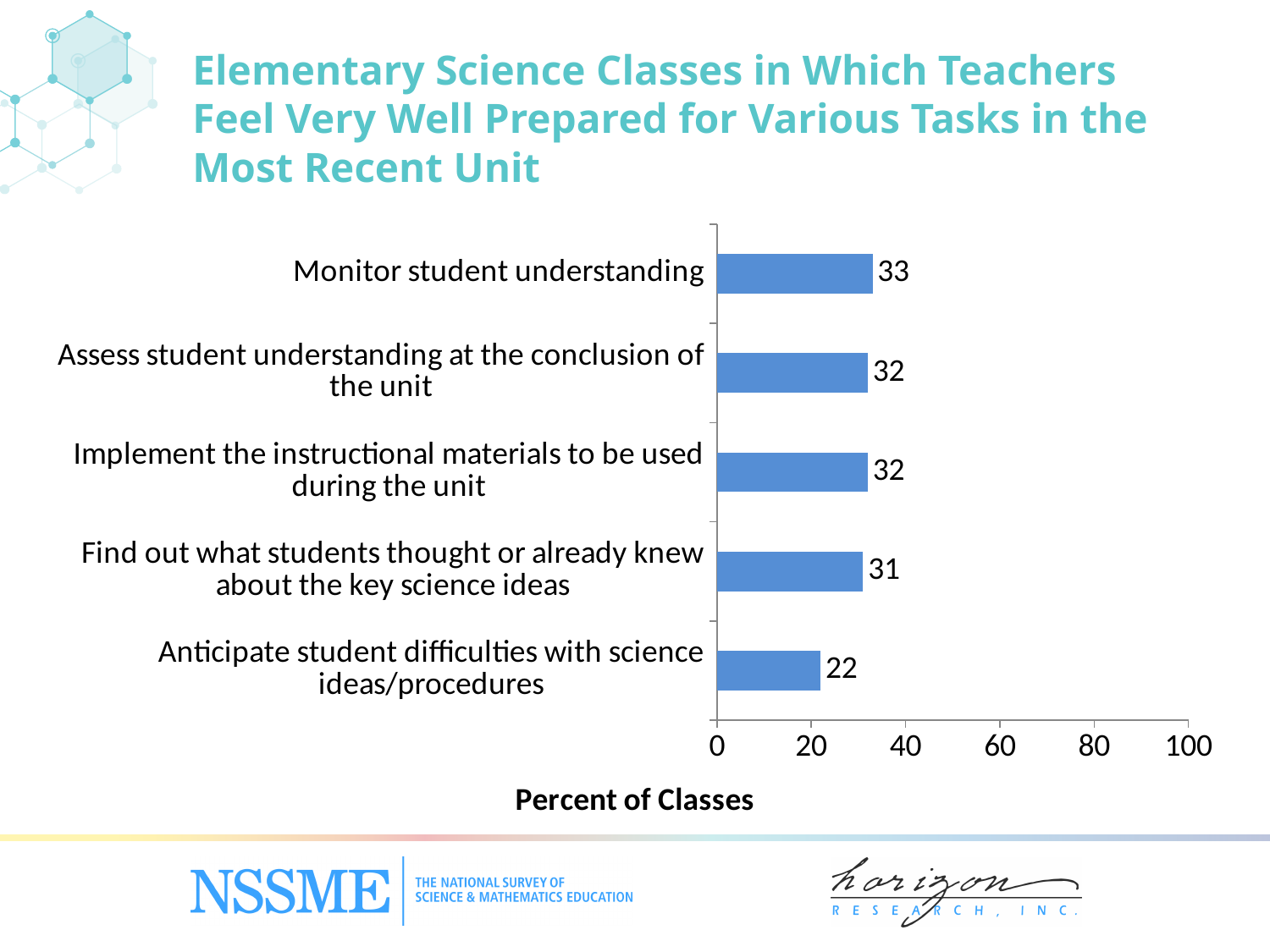
Which task has the lowest percent of classes? Anticipate student difficulties with science ideas/procedures What is the value for "Anticipate student difficulties with science ideas/procedures"? 22 Which task has the highest percent of classes? Monitor student understanding How many tasks (categories) are shown in the chart? 5 What is the label of the horizontal axis? Percent of Classes What is the value for "Implement the instructional materials to be used during the unit"? 32 What percent of classes is shown for "Monitor student understanding"? 33 What is the difference between the values for "Monitor student understanding" and "Anticipate student difficulties with science ideas/procedures"? 11 What is the value for "Find out what students thought or already knew about the key science ideas"? 31 What kind of chart is shown on the slide? bar chart Which is larger: the value for "Assess student understanding at the conclusion of the unit" or the value for "Anticipate student difficulties with science ideas/procedures"? Assess student understanding at the conclusion of the unit Is the value for "Monitor student understanding" greater or less than 40? less